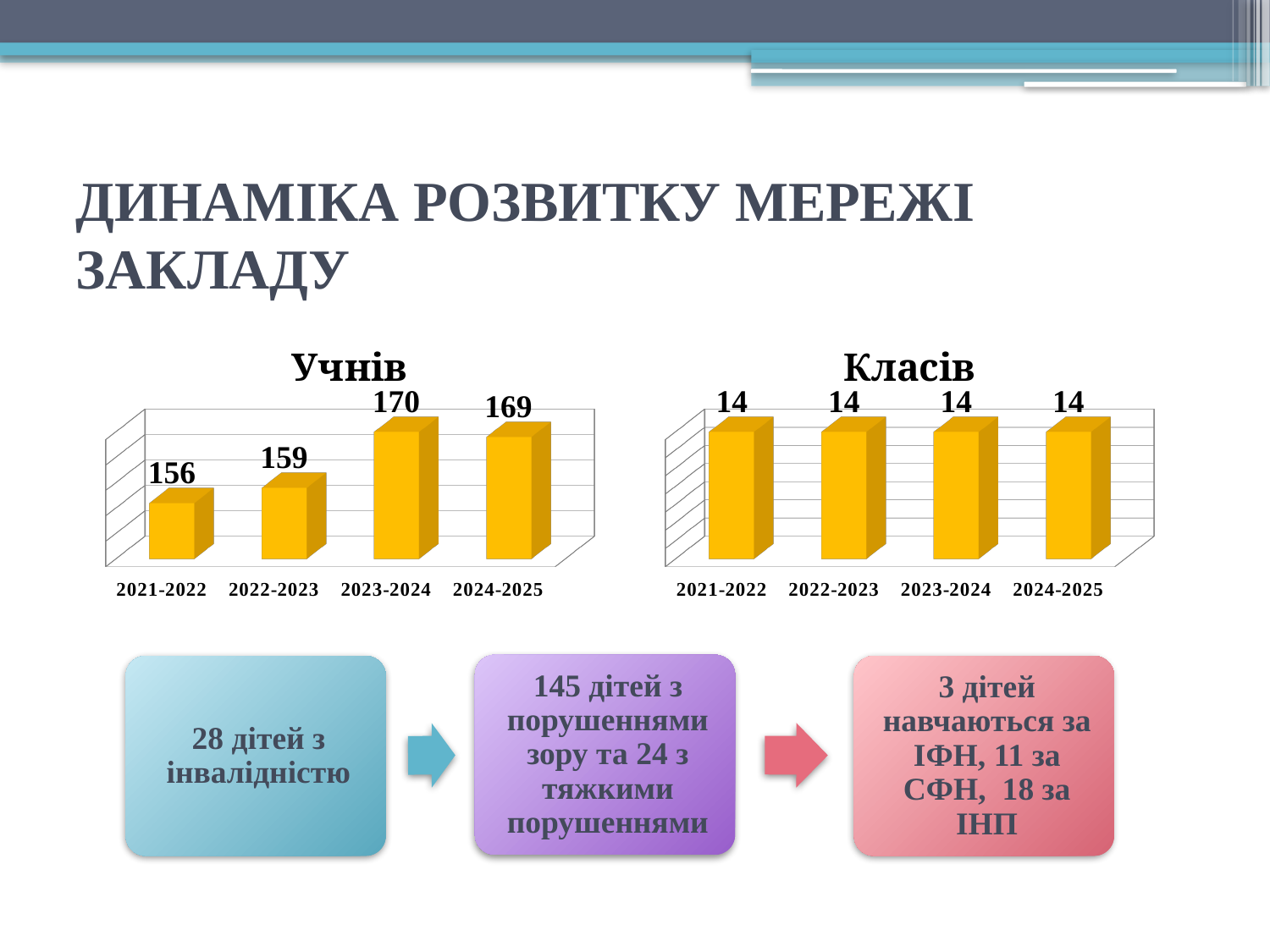
In the 'Класів' chart, do the values rise, fall or stay the same across the years? stay the same In the 'Учнів' chart, how many categories are shown on the x axis? 4 In the 'Учнів' chart, which year has the highest value? 2023-2024 In the 'Класів' chart, what is the value for 2024-2025? 14 In the 'Учнів' chart, which year has the lowest value? 2021-2022 In the 'Учнів' chart, what is the value for 2021-2022? 156 What kind of chart is the 'Учнів' chart? bar chart In the 'Класів' chart, how many categories are shown on the x axis? 4 In the 'Учнів' chart, what is the difference between the values for 2023-2024 and 2021-2022? 14 In the 'Учнів' chart, which is larger, the value for 2022-2023 or the value for 2024-2025? 2024-2025 In the 'Учнів' chart, what is the value for 2023-2024? 170 What is the title of the chart on the right side of the slide? Класів